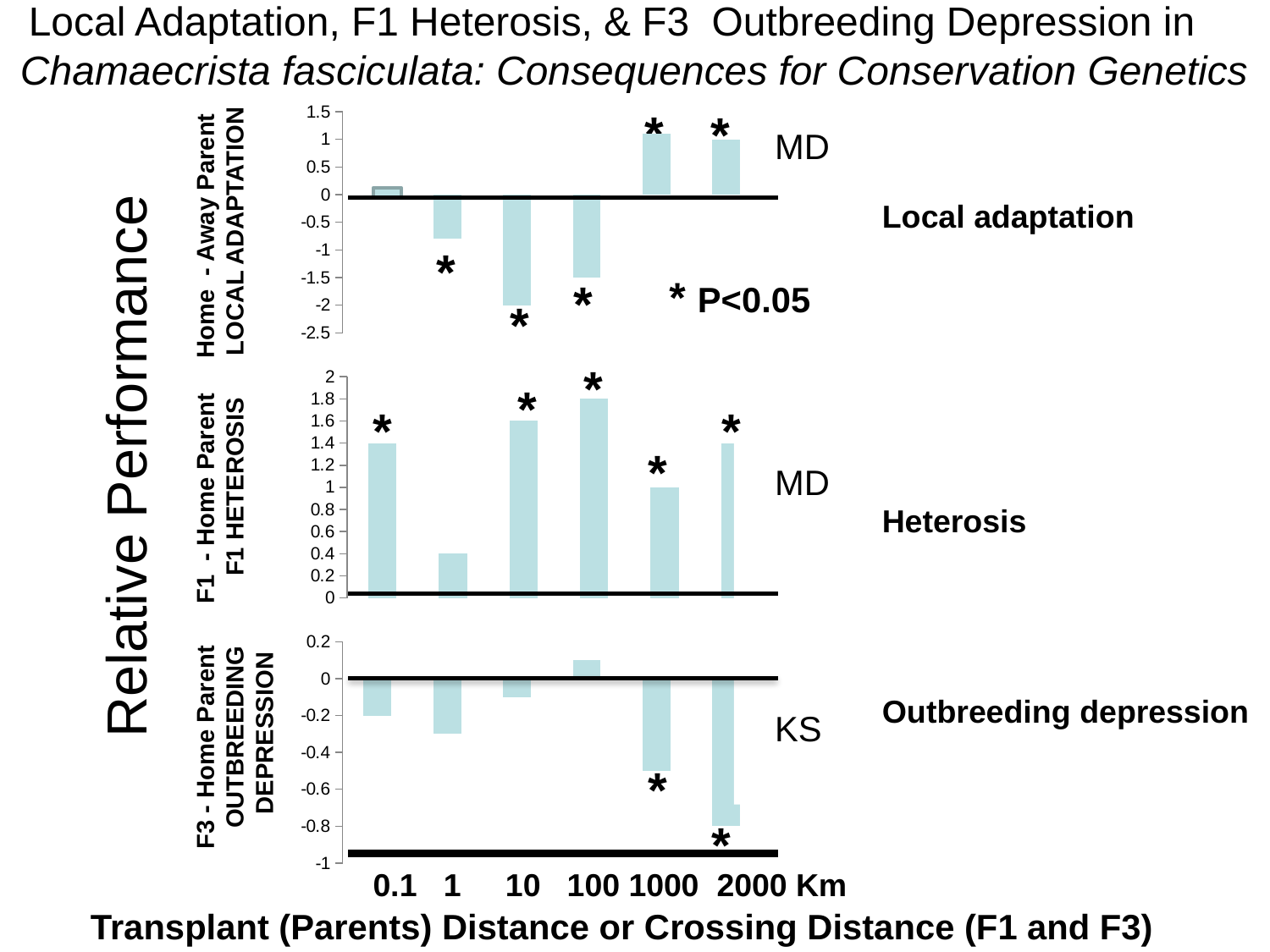
Which population label is shown next to the Outbreeding depression chart? KS In the Heterosis chart, which is larger, the value for 10 Km or the value for 1000 Km? 10 Km In the Local adaptation chart, which is larger, the value for 1000 Km or the value for 1 Km? 1000 Km In the Heterosis chart, which distance has the lowest value? 1 What kind of chart is the Heterosis chart in the middle of the slide? bar chart In the Heterosis chart, is the value for 100 Km greater or less than 1.6? greater In the Local adaptation chart, is the value for 10 Km greater or less than -1.5? less In the Local adaptation chart, is the value for 1000 Km greater or less than 0.5? greater How many distance categories are shown along the x axis of the charts? 6 In the Outbreeding depression chart, which distance has the lowest value? 2000 In the Heterosis chart, which distance has the highest value? 100